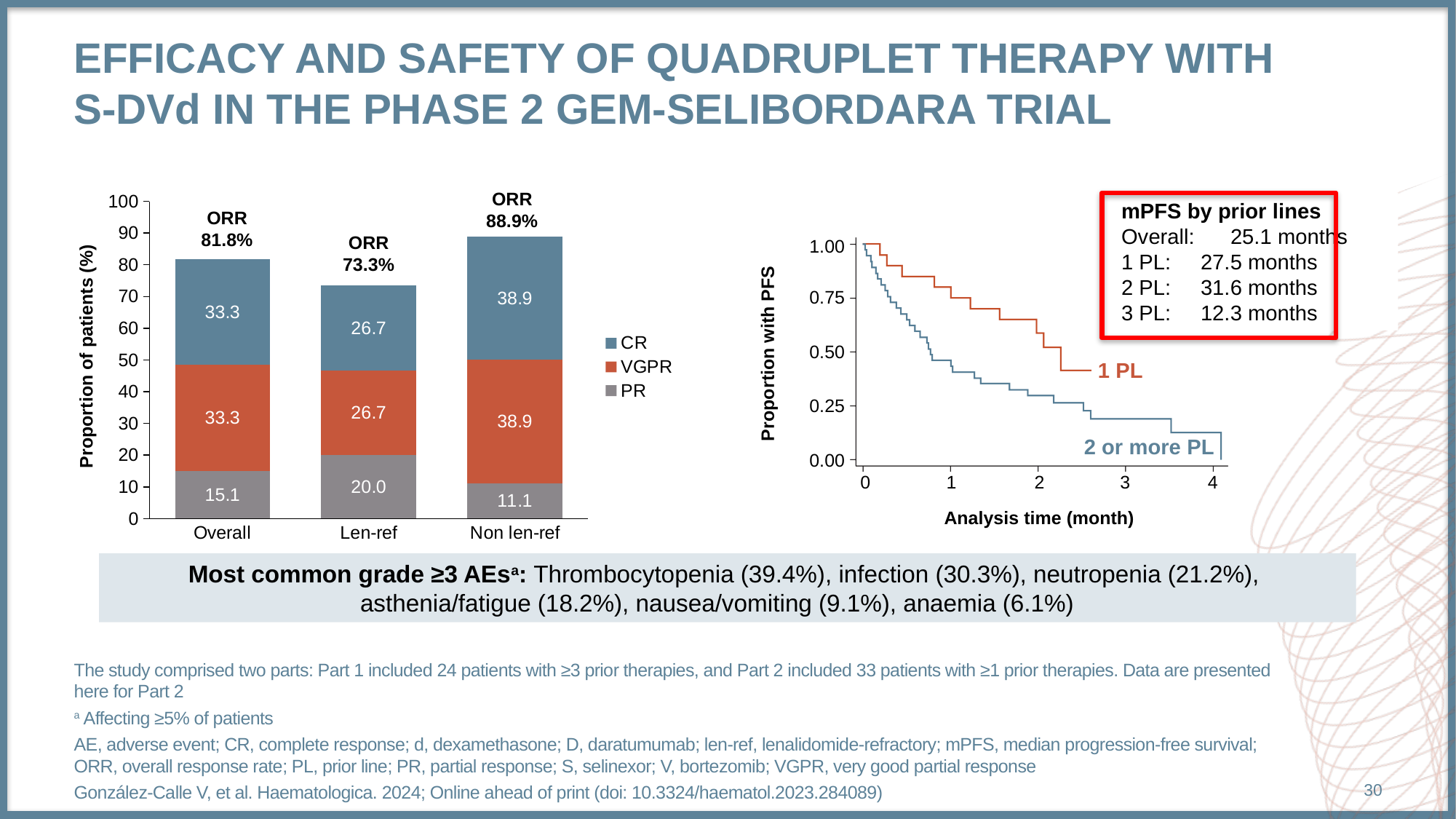
In the bar chart on the left, how many groups are shown on the x axis? 3 In the PFS chart on the right, is the proportion with PFS for the 2 or more PL curve at 1 month greater or less than 0.50? less In the bar chart on the left, what ORR is shown above the Overall bar? 81.8% What kind of chart is the chart on the left? Stacked bar chart In the bar chart on the left, what is the PR value for the Len-ref group? 20.0 In the bar chart on the left, what is the difference between the CR values for Non len-ref and Len-ref? 12.2 In the bar chart on the left, which group has the highest ORR? Non len-ref In the bar chart on the left, which group has the lowest PR value? Non len-ref In the bar chart on the left, what is the CR value for the Non len-ref group? 38.9 In the PFS chart on the right, what is the label of the x axis? Analysis time (month) In the bar chart on the left, is the VGPR value larger for Overall or for Len-ref? Overall In the bar chart on the left, how many series does the legend list? 3